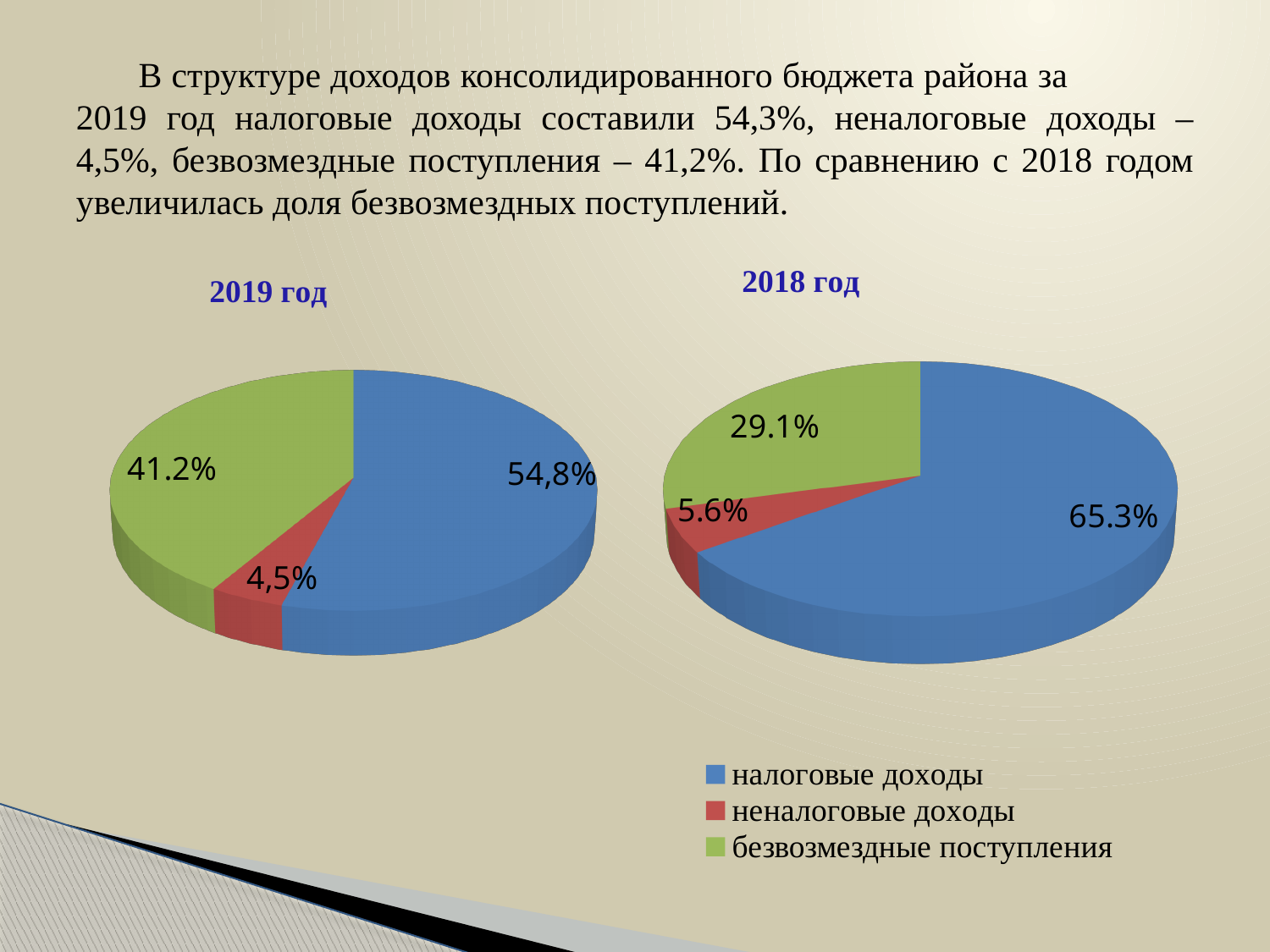
What kind of chart is the "2019 год" chart? pie chart In the "2019 год" chart, what is the value shown for неналоговые доходы? 4,5% How many entries does the legend list? 3 In the "2019 год" chart, which category has the smallest slice? неналоговые доходы In the "2018 год" chart, what is the value shown for неналоговые доходы? 5.6% In the "2019 год" chart, what is the value shown for безвозмездные поступления? 41.2% In the "2019 год" chart, what is the value shown for налоговые доходы? 54,8% How many slices does the "2018 год" pie chart have? 3 Which is larger: безвозмездные поступления in the "2019 год" chart or in the "2018 год" chart? 2019 год In the "2018 год" chart, what is the value shown for безвозмездные поступления? 29.1% In the "2018 год" chart, which category has the largest slice? налоговые доходы In the "2018 год" chart, what is the value shown for налоговые доходы? 65.3%